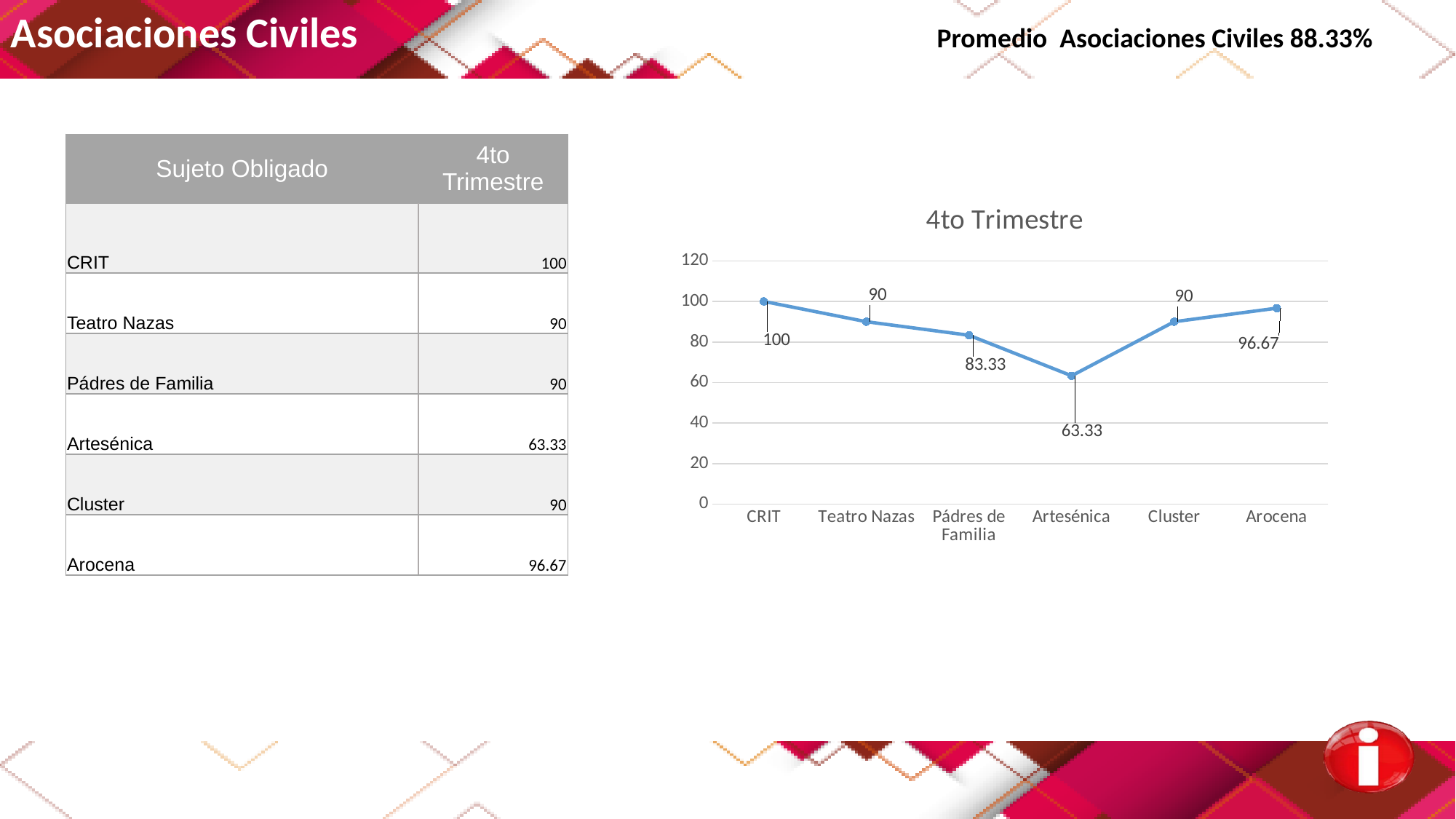
What is the value for Arocena in the 4to Trimestre chart? 96.67 What is the value for Artesénica in the 4to Trimestre chart? 63.33 What is the value for CRIT in the 4to Trimestre chart? 100 Which category has the highest value in the 4to Trimestre chart? CRIT What is the title of the chart on the slide? 4to Trimestre Which has a larger value in the 4to Trimestre chart, Arocena or Pádres de Familia? Arocena What is the difference between the values for CRIT and Artesénica in the 4to Trimestre chart? 36.67 What kind of chart is the 4to Trimestre chart? Line chart Which category has the lowest value in the 4to Trimestre chart? Artesénica How many categories are plotted in the 4to Trimestre chart? 6 What is the difference between the values for Arocena and Cluster in the 4to Trimestre chart? 6.67 What is the value for Pádres de Familia in the 4to Trimestre chart? 83.33